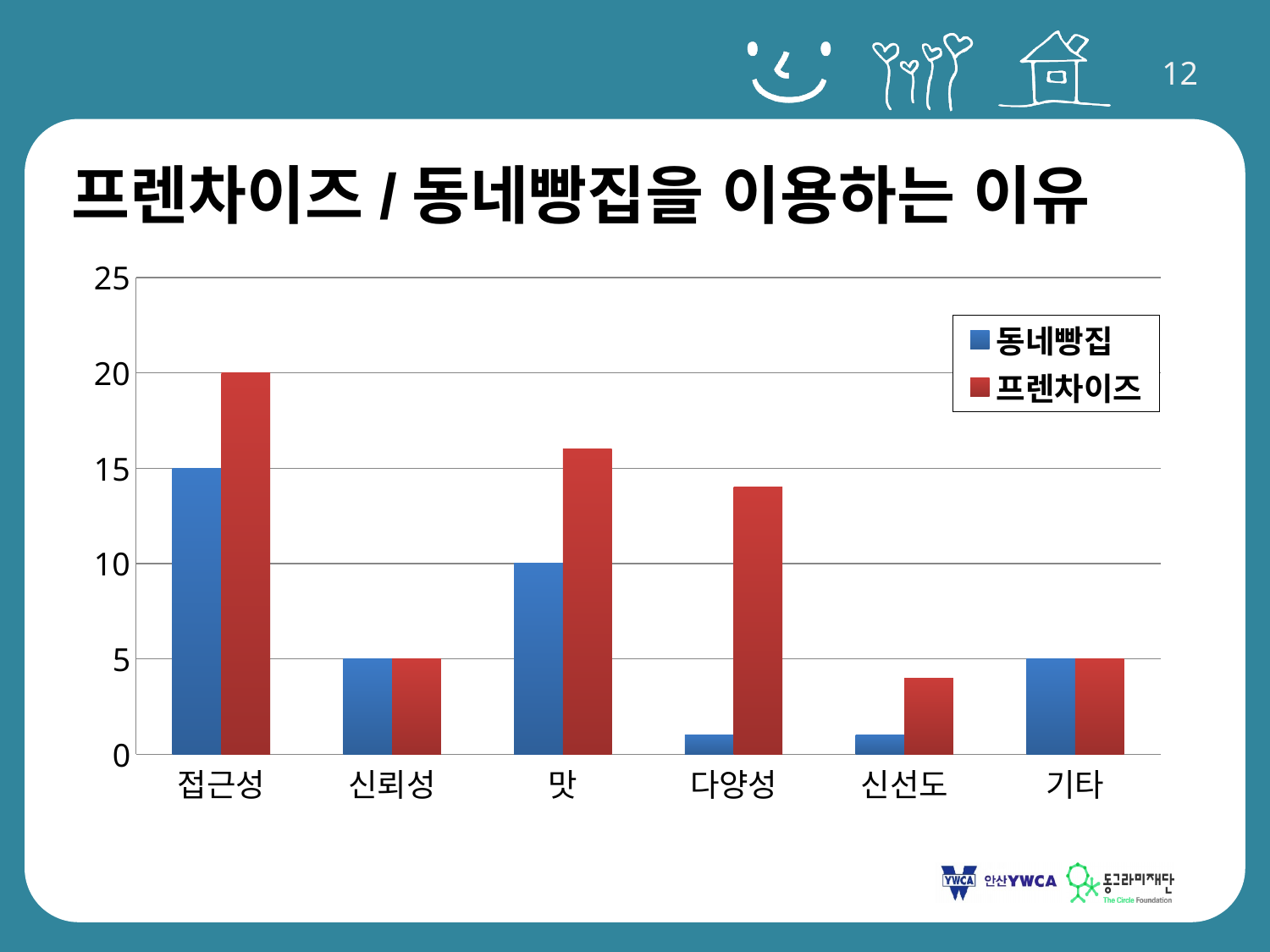
Is the value for 프렌차이즈 in the 다양성 category greater or less than 10? greater What is the value for 동네빵집 in the 접근성 category? 15 Which series has the larger value in the 맛 category, 동네빵집 or 프렌차이즈? 프렌차이즈 What is the value for 동네빵집 in the 기타 category? 5 Which category has the highest value for 프렌차이즈? 접근성 What type of chart is shown on the slide? bar chart What is the value for 동네빵집 in the 맛 category? 10 Which category has the highest value for 동네빵집? 접근성 Is the value for 동네빵집 in the 신선도 category greater or less than 5? less What is the value for 프렌차이즈 in the 접근성 category? 20 How many categories are shown on the x axis? 6 How many series does the legend list? 2